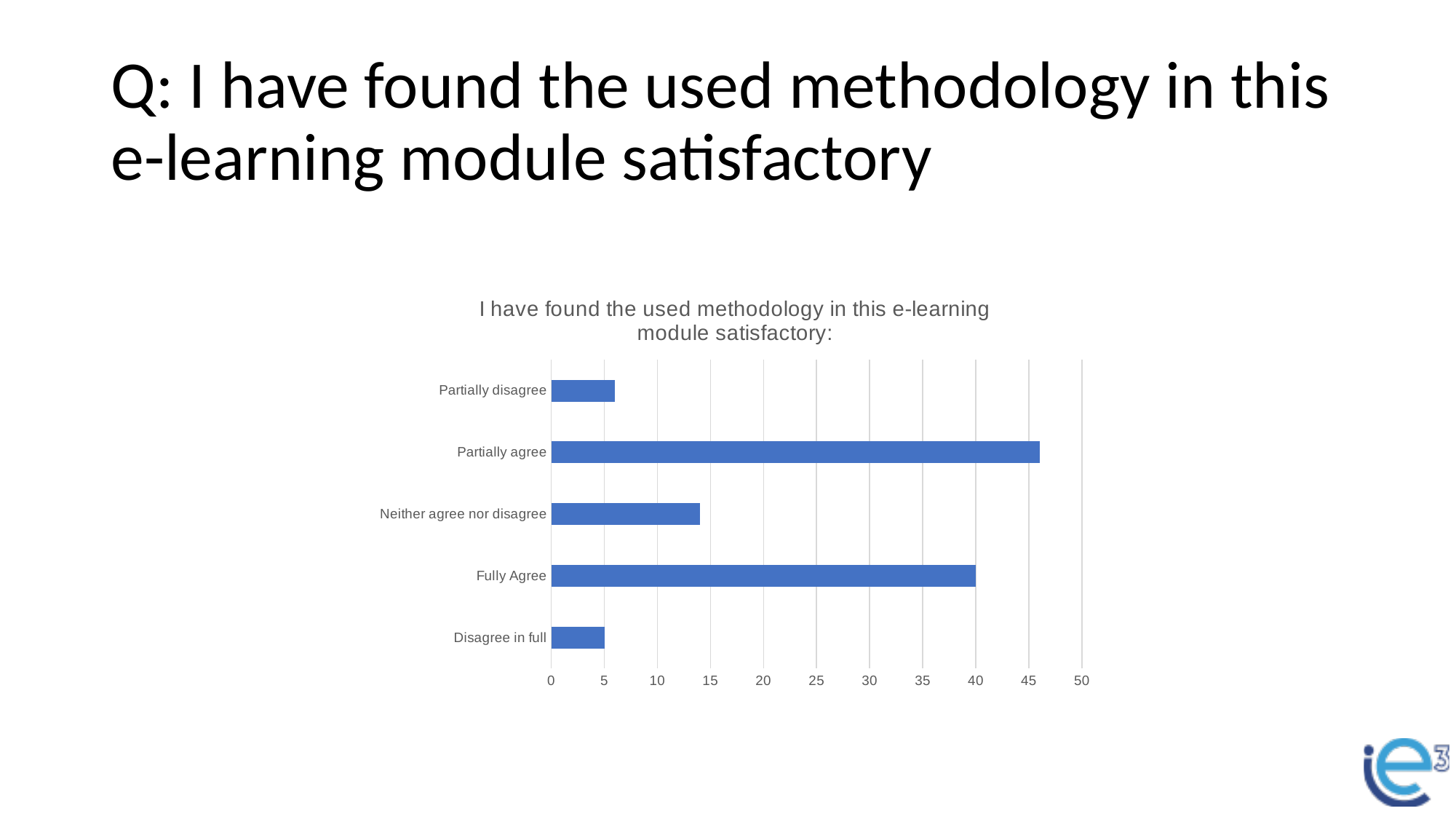
Which is larger, the value for Partially agree or the value for Fully Agree? Partially agree Which category has the highest value in the chart? Partially agree How many categories are shown in the chart? 5 What is the title of the chart? I have found the used methodology in this e-learning module satisfactory: Is the value for Partially agree greater or less than 45? greater What is the maximum value shown on the horizontal axis of the chart? 50 What is the value for Fully Agree? 40 Is the value for Partially disagree greater or less than 10? less What is the value for Disagree in full? 5 Which is larger, the value for Neither agree nor disagree or the value for Partially disagree? Neither agree nor disagree Is the value for Neither agree nor disagree greater or less than 10? greater What type of chart is shown on the slide? bar chart